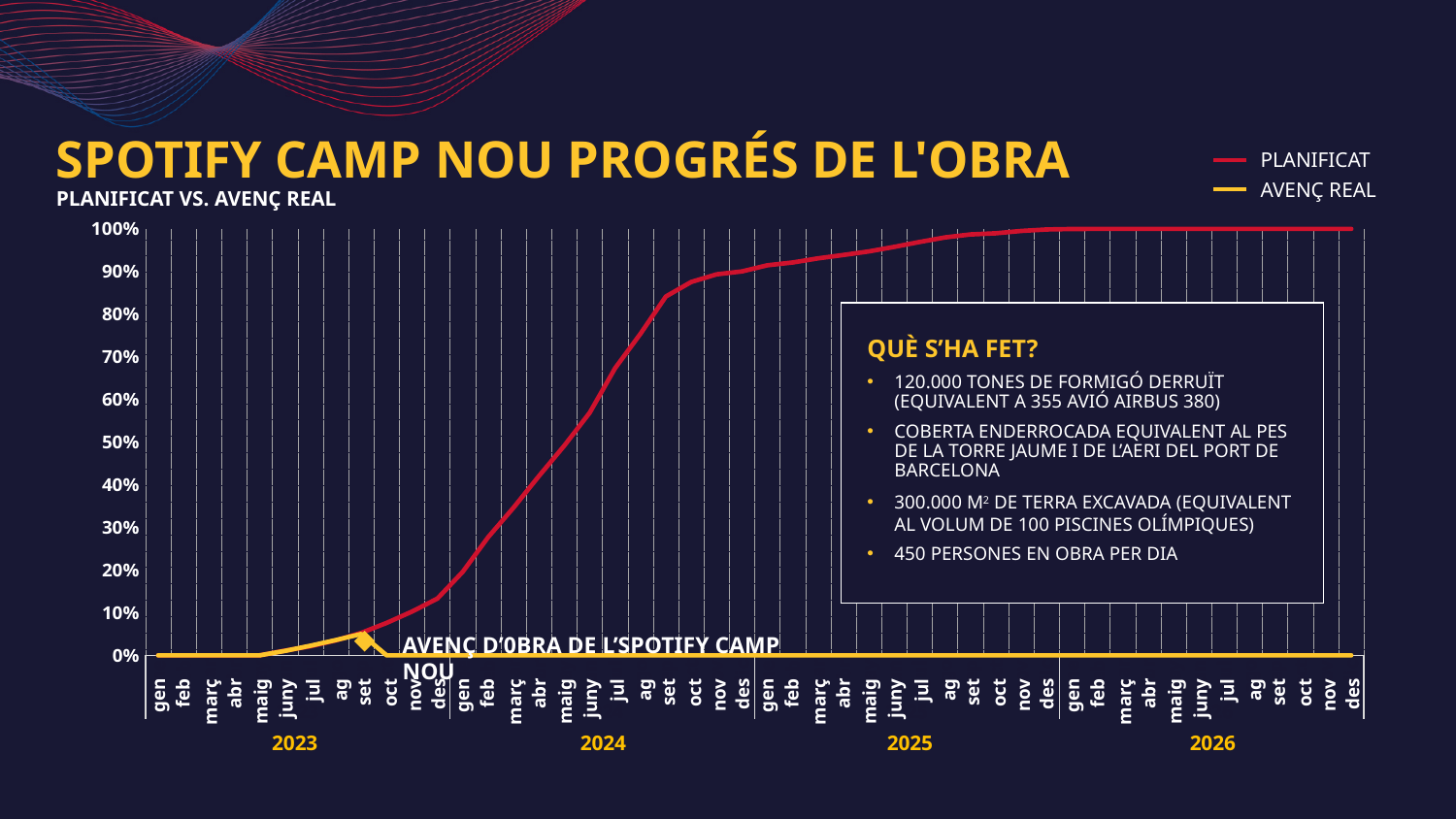
Is the PLANIFICAT value for jul 2024 greater or less than 50%? greater Is the PLANIFICAT value for des 2024 greater or less than 80%? greater Does the PLANIFICAT line rise or fall from 2023 to 2026? rise What kind of chart is shown on the slide? line chart What is the AVENÇ REAL value for gen 2023? 0% How many series does the legend list? 2 Is the PLANIFICAT value for gen 2024 greater or less than 30%? less Which series is drawn in red according to the legend? PLANIFICAT How many years are labelled along the x axis? 4 In jul 2024, which series has the larger value, PLANIFICAT or AVENÇ REAL? PLANIFICAT Which series is drawn in yellow according to the legend? AVENÇ REAL